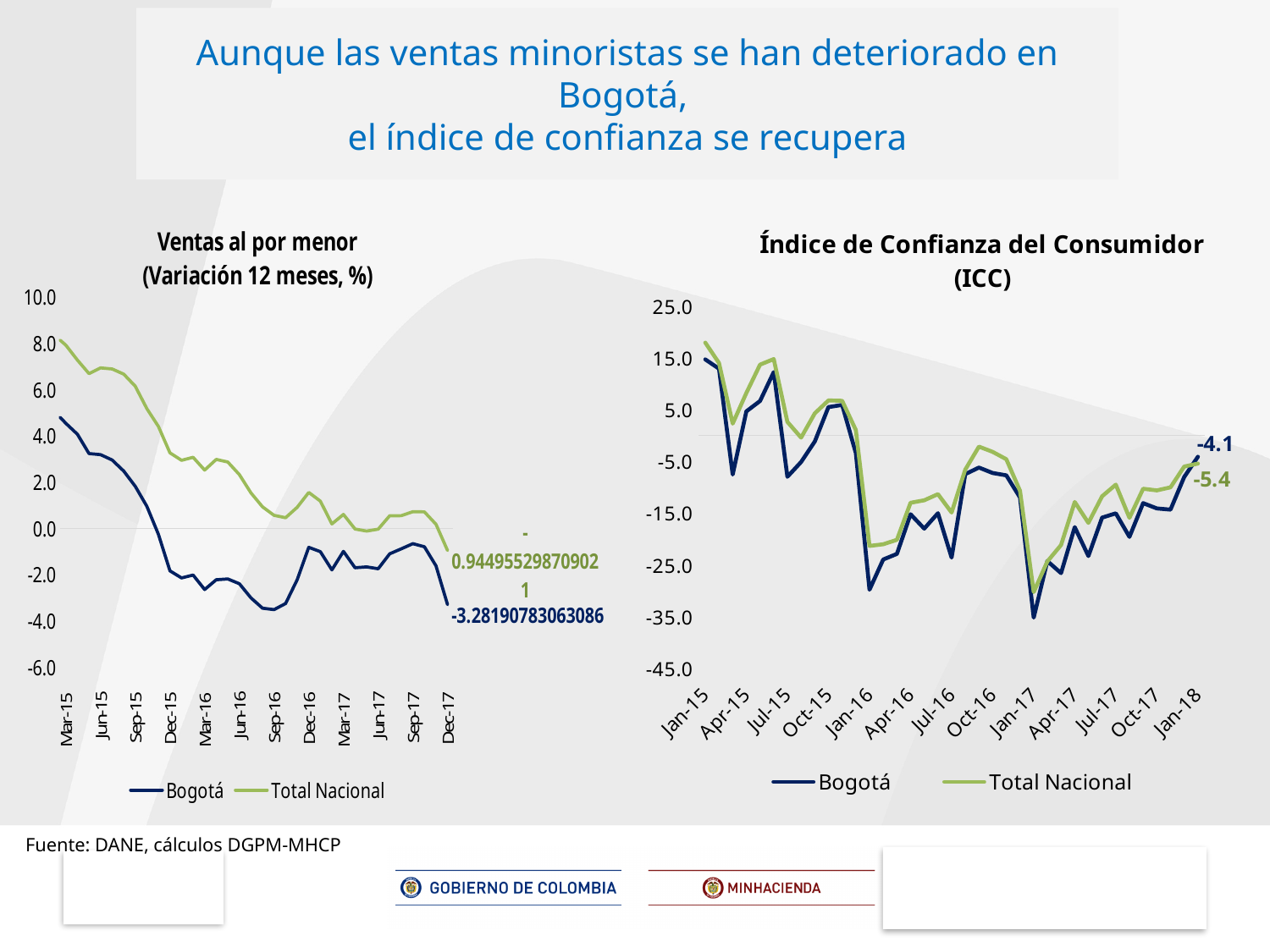
On the 'Ventas al por menor' chart, what is the value for Total Nacional at Dec-17? -0.944955298709021 On the 'Ventas al por menor' chart, does the Bogotá series overall rise or fall from Mar-15 to Dec-17? Fall On the 'Ventas al por menor' chart, what kind of chart is shown? Line chart On the 'Ventas al por menor' chart, which series has the higher value at Dec-17, Bogotá or Total Nacional? Total Nacional On the 'Índice de Confianza del Consumidor (ICC)' chart, what is the difference between the Bogotá and Total Nacional values at Jan-18? 1.3 On the 'Índice de Confianza del Consumidor (ICC)' chart, what is the value for Bogotá at Jan-18? -4.1 On the 'Índice de Confianza del Consumidor (ICC)' chart, which series is drawn in green? Total Nacional On the 'Índice de Confianza del Consumidor (ICC)' chart, what is the value for Total Nacional at Jan-18? -5.4 On the 'Ventas al por menor' chart, how many series does the legend list? 2 On the 'Ventas al por menor' chart, what is the value for Bogotá at Dec-17? -3.28190783063086 On the 'Índice de Confianza del Consumidor (ICC)' chart, is the value for Bogotá at Jan-17 greater or less than -25.0? less On the 'Ventas al por menor' chart, is the value for Bogotá at Mar-15 greater or less than 4.0? greater